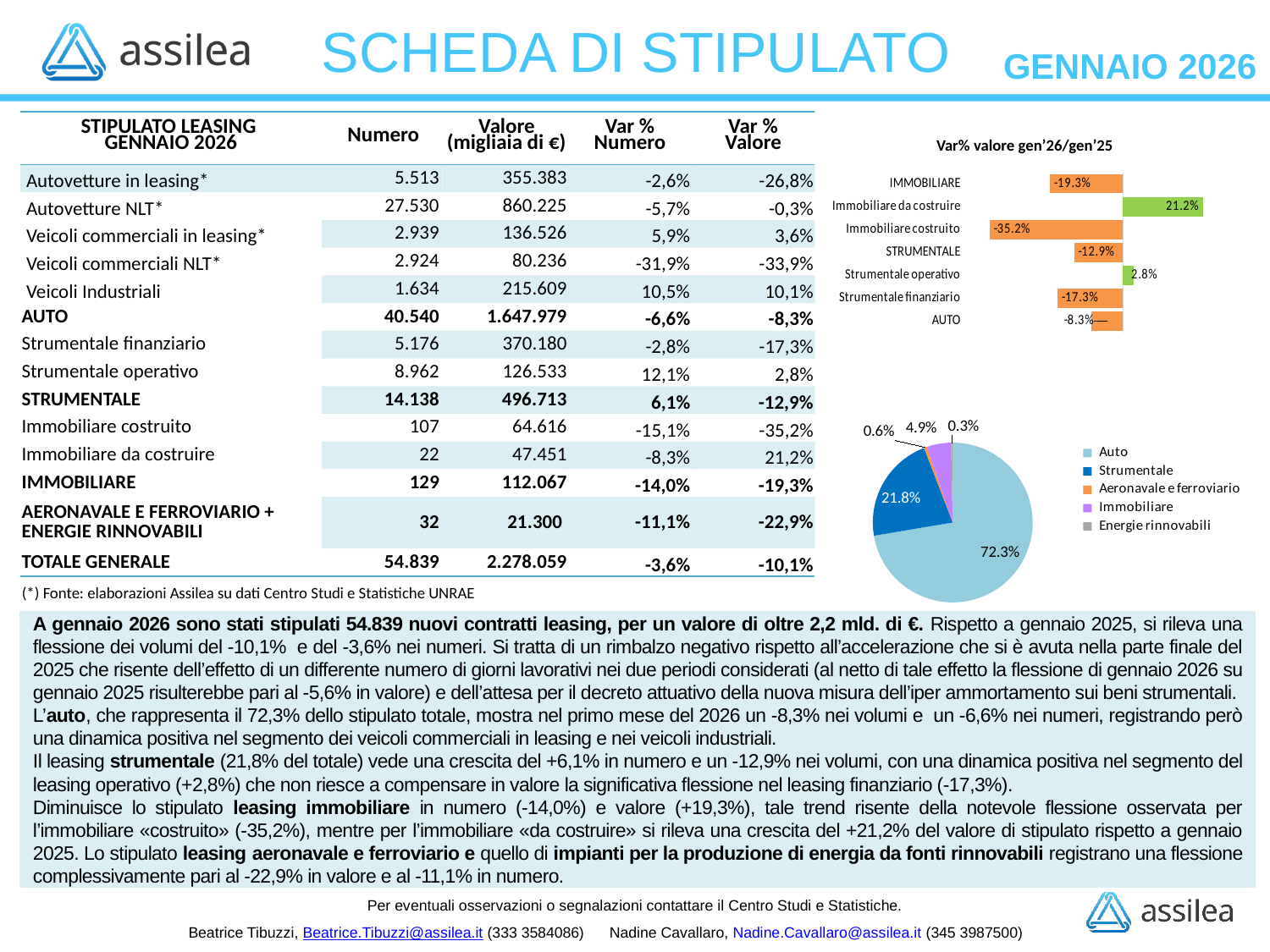
In the bar chart titled "Var% valore gen'26/gen'25", which is larger, the value for STRUMENTALE or the value for Strumentale finanziario? STRUMENTALE In the bar chart titled "Var% valore gen'26/gen'25", which category has the lowest value? Immobiliare costruito How many entries does the legend of the pie chart at the bottom right list? 5 In the bar chart titled "Var% valore gen'26/gen'25", what is the value for AUTO? -8.3% In the bar chart titled "Var% valore gen'26/gen'25", how many categories are shown? 7 In the pie chart at the bottom right, what share does Auto have? 72.3% In the bar chart titled "Var% valore gen'26/gen'25", which category has the highest value? Immobiliare da costruire In the bar chart titled "Var% valore gen'26/gen'25", what is the value for Immobiliare da costruire? 21.2% What kind of chart is the one titled "Var% valore gen'26/gen'25"? Bar chart In the bar chart titled "Var% valore gen'26/gen'25", what is the value for Immobiliare costruito? -35.2% In the bar chart titled "Var% valore gen'26/gen'25", what is the difference between the values for Immobiliare da costruire and Strumentale operativo? 18.4 percentage points In the pie chart at the bottom right, what share does Strumentale have? 21.8%